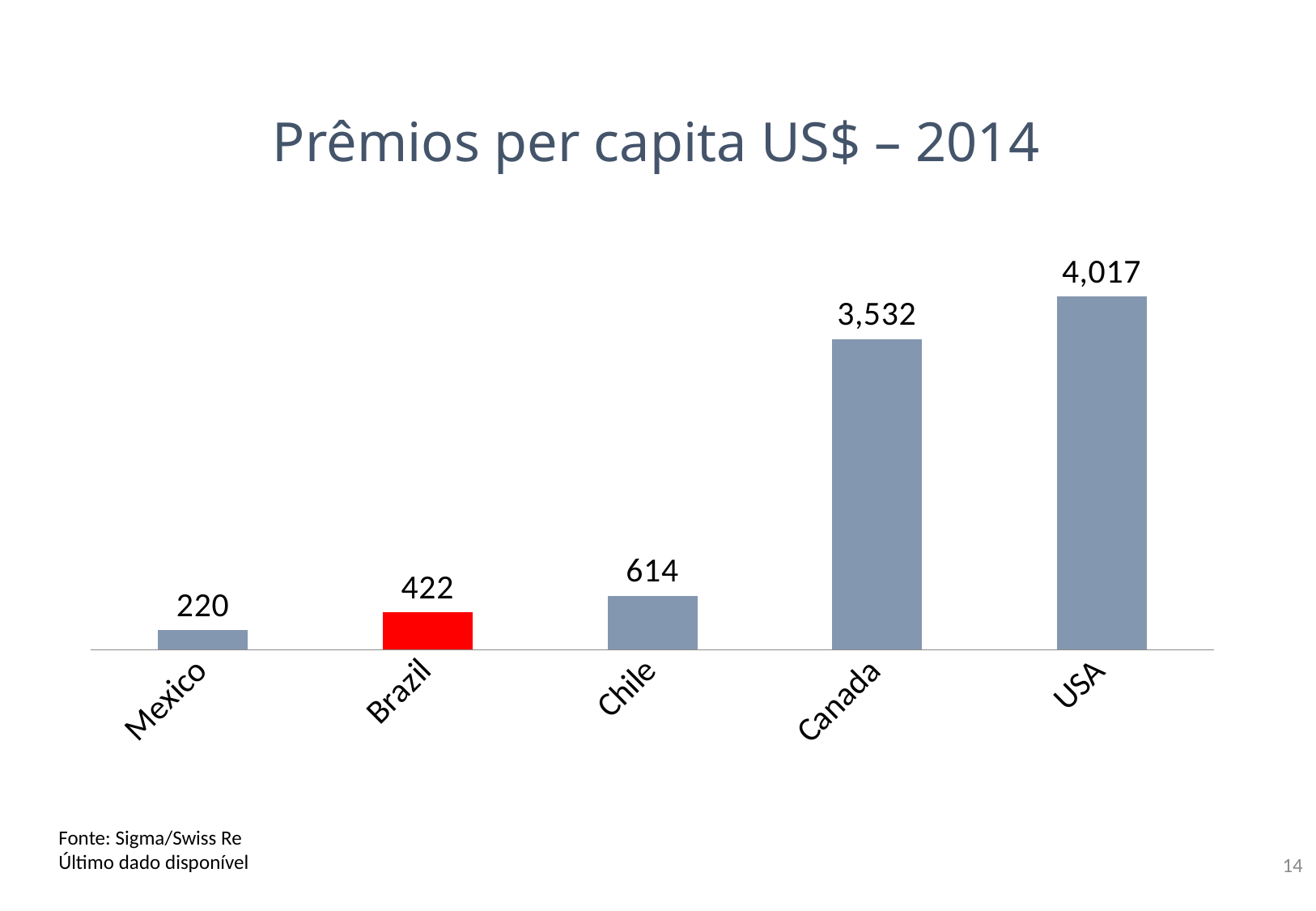
What is the value for Brazil? 422 Do the values rise or fall from left to right along the x axis? rise What is the difference between the values for Chile and Brazil? 192 Which is larger, the value for Chile or the value for Brazil? Chile How many countries are shown in the chart? 5 Which country has the highest value? USA What is the value for Mexico? 220 Which country has the lowest value? Mexico What is the value for Canada? 3,532 Which country's bar is coloured red? Brazil What kind of chart is this? bar chart What is the difference between the values for USA and Canada? 485